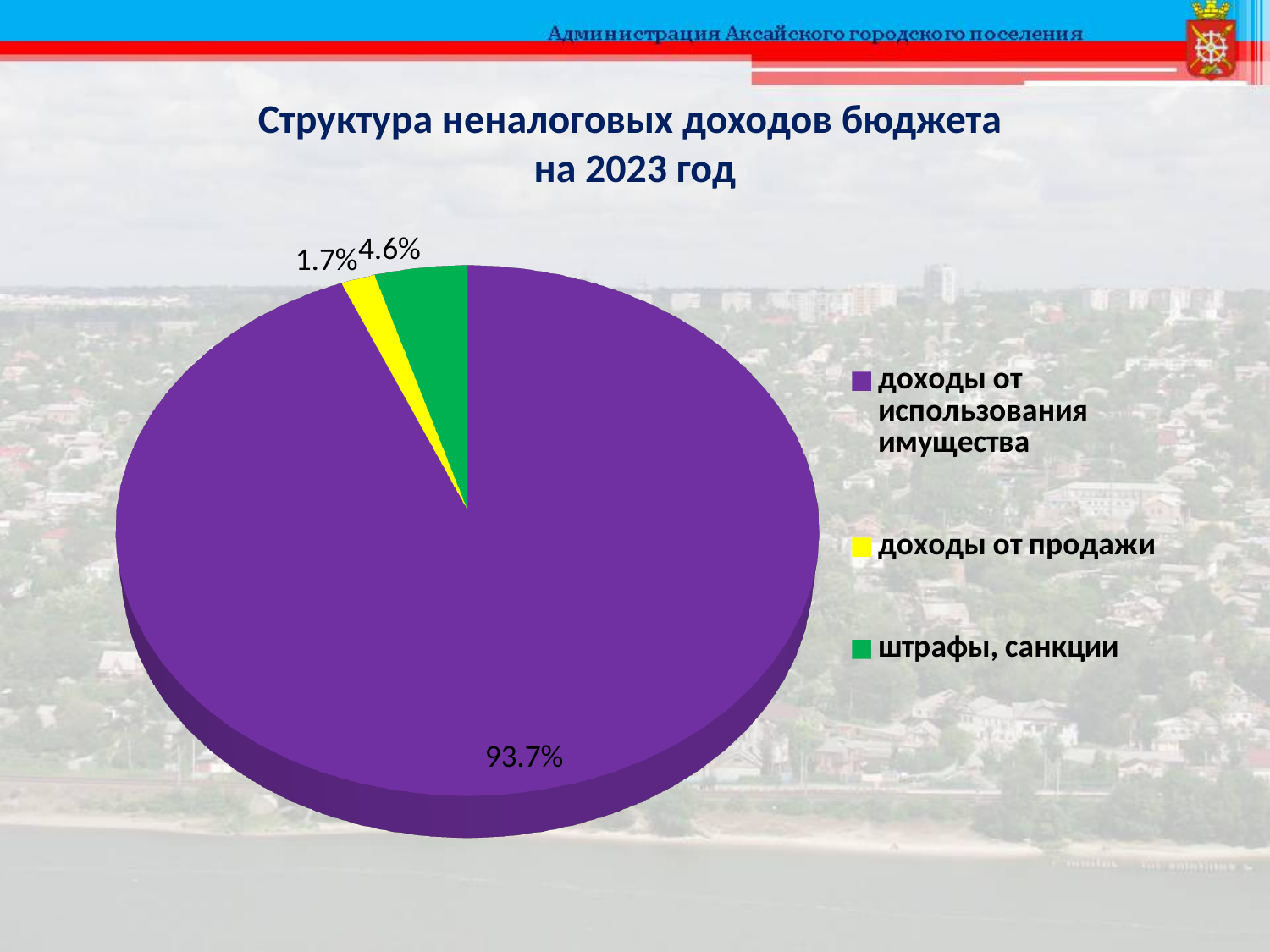
Which category has the largest slice of the pie? доходы от использования имущества What share of the pie is labelled for "доходы от продажи"? 1.7% How many slices does the pie chart have? 3 What type of chart is shown on the slide? pie chart What colour is the slice for "доходы от продажи"? yellow Which is larger: the slice for "штрафы, санкции" or the slice for "доходы от продажи"? штрафы, санкции Which category has the smallest slice of the pie? доходы от продажи What is the difference in percentage points between the "доходы от использования имущества" slice and the "штрафы, санкции" slice? 89.1 What is the difference in percentage points between the "штрафы, санкции" slice and the "доходы от продажи" slice? 2.9 What share of the pie is labelled for "доходы от использования имущества"? 93.7% What share of the pie is labelled for "штрафы, санкции"? 4.6% What is the title of the chart on the slide? Структура неналоговых доходов бюджета на 2023 год